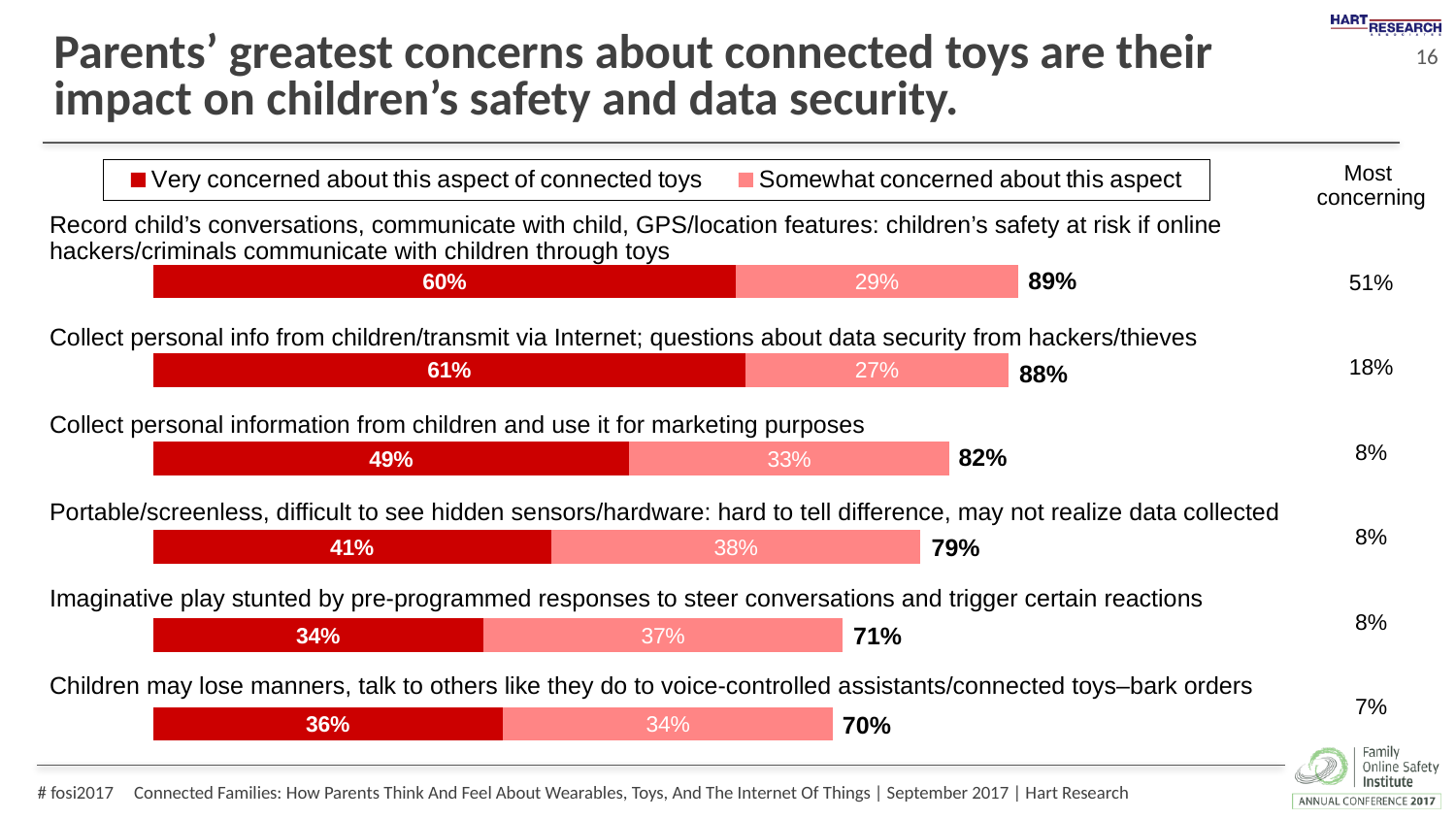
What percentage of parents are somewhat concerned that portable/screenless toys with hidden sensors make it hard to realize data is collected? 38% What is the difference between the 'very concerned' percentages for collecting personal info for data security (61%) and collecting personal information for marketing purposes (49%)? 12 percentage points Which has a larger 'very concerned' share: imaginative play stunted by pre-programmed responses, or children may lose manners? Children may lose manners Which concern has the lowest combined total of very and somewhat concerned parents? Children may lose manners, talk to others like they do to voice-controlled assistants/connected toys–bark orders What percentage of parents chose the concern about recording child's conversations and GPS/location features as the most concerning? 51% What kind of chart is shown on the slide? Stacked horizontal bar chart How many series does the legend list? 2 Which colour represents 'Very concerned about this aspect of connected toys' in the legend? Dark red What percentage of parents are very concerned that connected toys collect personal info from children and transmit it via the Internet, raising data security questions? 61% Which concern has the highest combined total of very and somewhat concerned parents? Record child's conversations, communicate with child, GPS/location features: children's safety at risk if online hackers/criminals communicate with children through toys How many concerns about connected toys are listed in the chart? 6 What is the combined total (very plus somewhat concerned) for the concern that children may lose manners and bark orders like they do to voice-controlled assistants? 70%